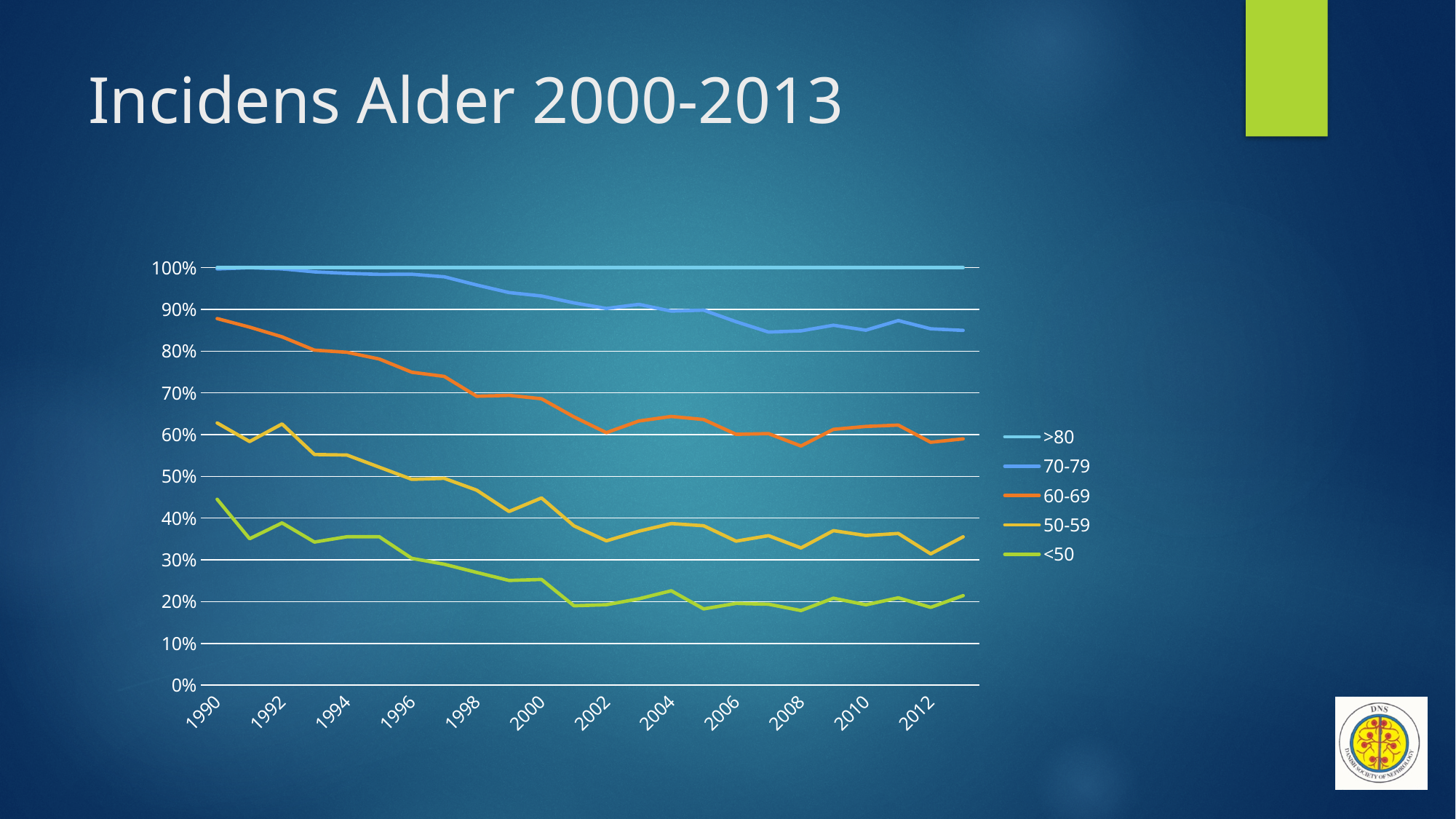
In 2000, which is higher: the 60-69 series or the 50-59 series? 60-69 Is the value for the 50-59 series in 2002 greater or less than 40%? less How many year labels are shown on the x axis? 12 Does the 60-69 series rise or fall from 1990 to 2002? fall What kind of chart is shown on the slide? line chart Is the value for the 70-79 series in 2008 greater or less than 90%? less What is the title of the slide? Incidens Alder 2000-2013 What is the value for the >80 series in 1990? 100% How many series does the legend list? 5 Is the value for the <50 series in 1990 greater or less than 40%? greater Which series has the lowest values across the whole period? <50 Which series is plotted at the top of the chart, staying at 100% throughout? >80